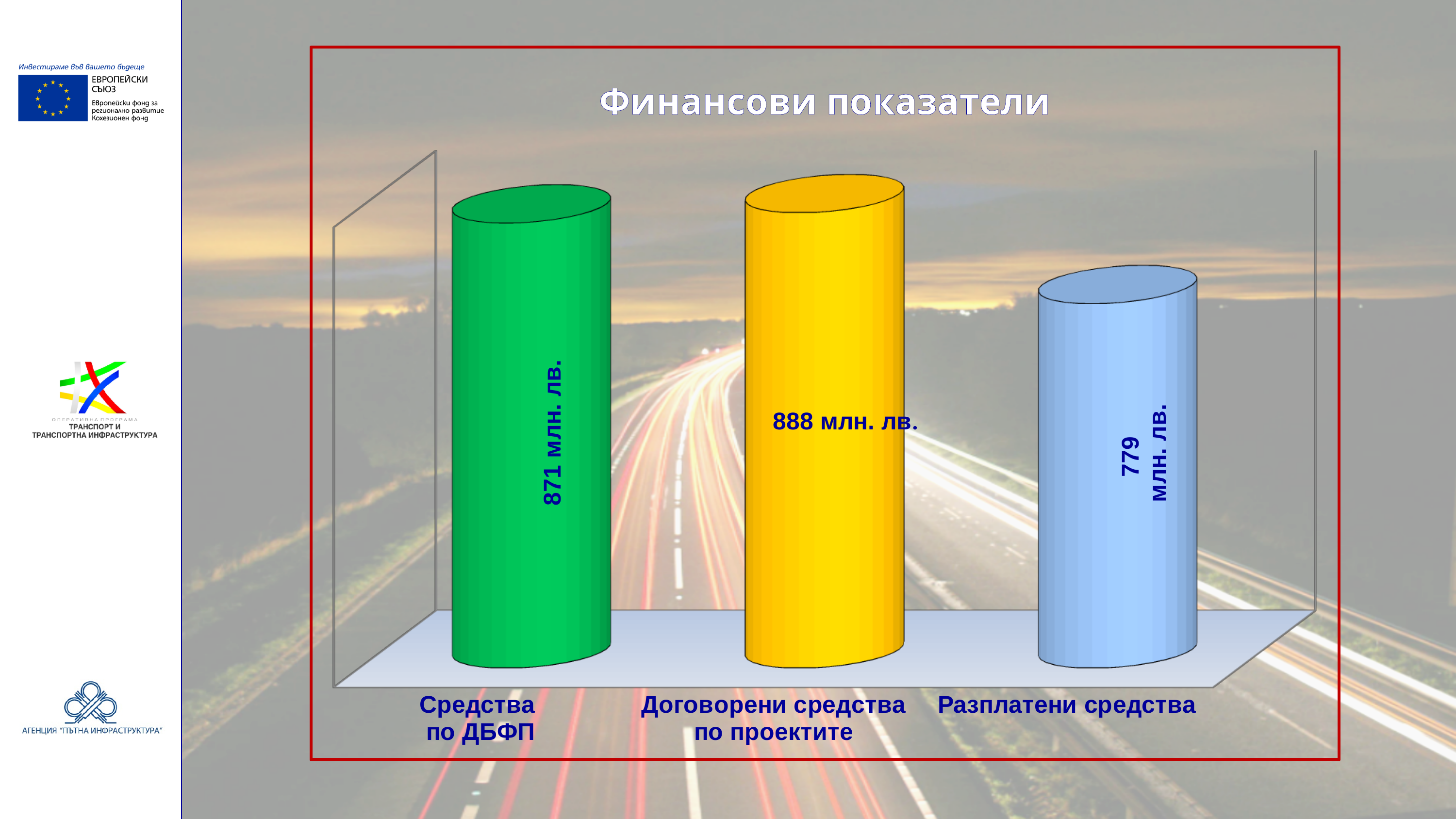
How many categories are shown in the chart? 3 Which is larger: Средства по ДБФП or Разплатени средства? Средства по ДБФП What type of chart is shown on the slide? bar chart What is the value for Средства по ДБФП? 871 млн. лв. What is the value for Разплатени средства? 779 млн. лв. What is the value for Договорени средства по проектите? 888 млн. лв. Which category has the lowest value? Разплатени средства What is the title of the chart? Финансови показатели What colour is the bar for Договорени средства по проектите? yellow Which category has the highest value? Договорени средства по проектите What is the difference between Договорени средства по проектите and Средства по ДБФП? 17 млн. лв. What is the difference between Средства по ДБФП and Разплатени средства? 92 млн. лв.